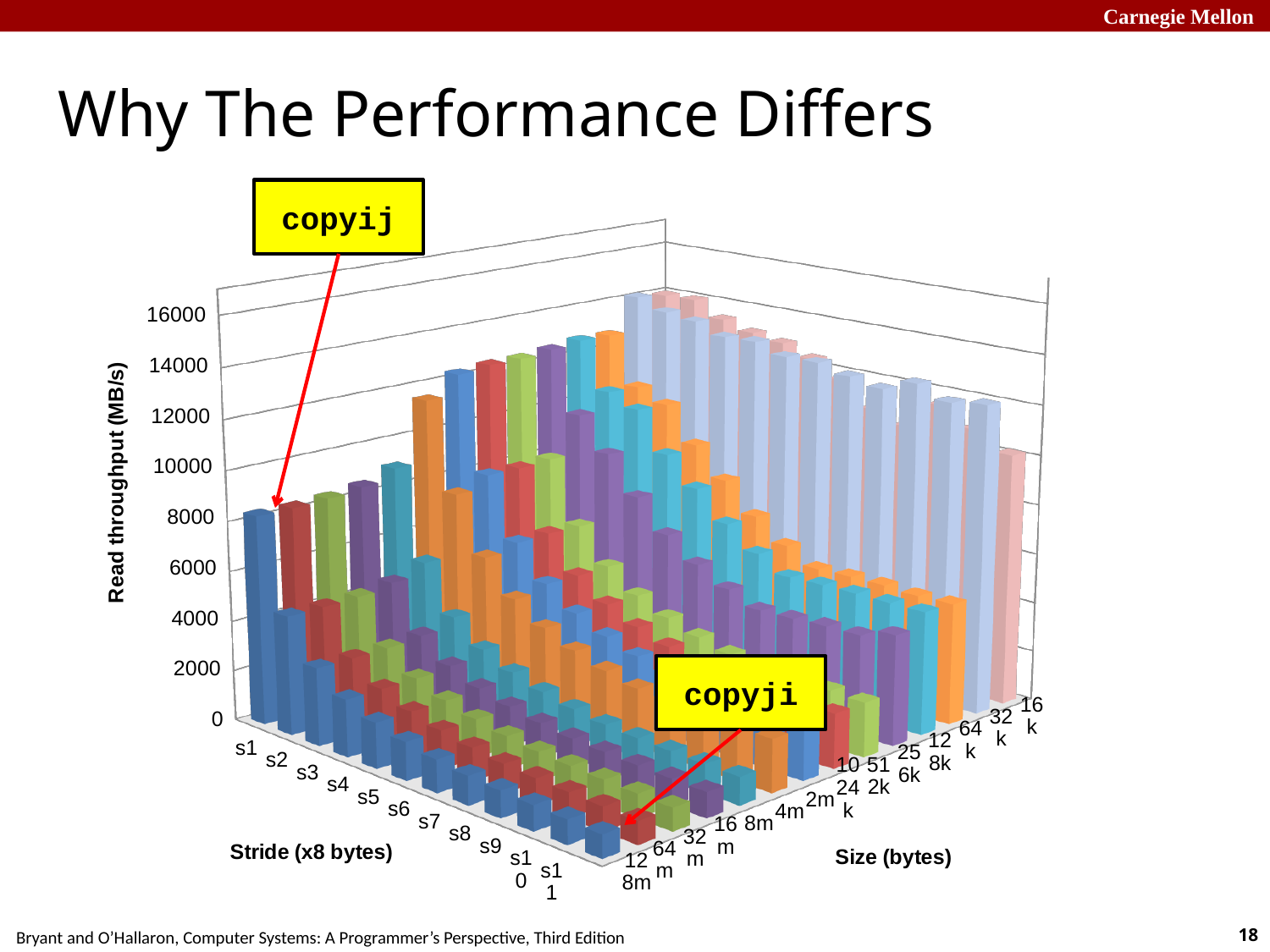
Is the read throughput for stride s11 at size 128m greater or less than 4000? less Is the read throughput for stride s1 at size 128m greater or less than 2000? greater What kind of chart is shown on the slide? 3D bar chart What is the title of the vertical axis of the chart? Read throughput (MB/s) What is the label of the stride axis of the chart? Stride (x8 bytes) At size 128m, which has the larger read throughput: stride s1 or stride s11? s1 How many size categories are shown along the Size (bytes) axis of the chart? 14 What is the highest tick value shown on the Read throughput axis? 16000 How many stride categories (s1 through s11) are shown on the chart? 11 Which size category has the largest read throughput values overall on the chart? 32k At size 128m, do the read throughput values rise or fall as the stride increases from s1 to s11? fall